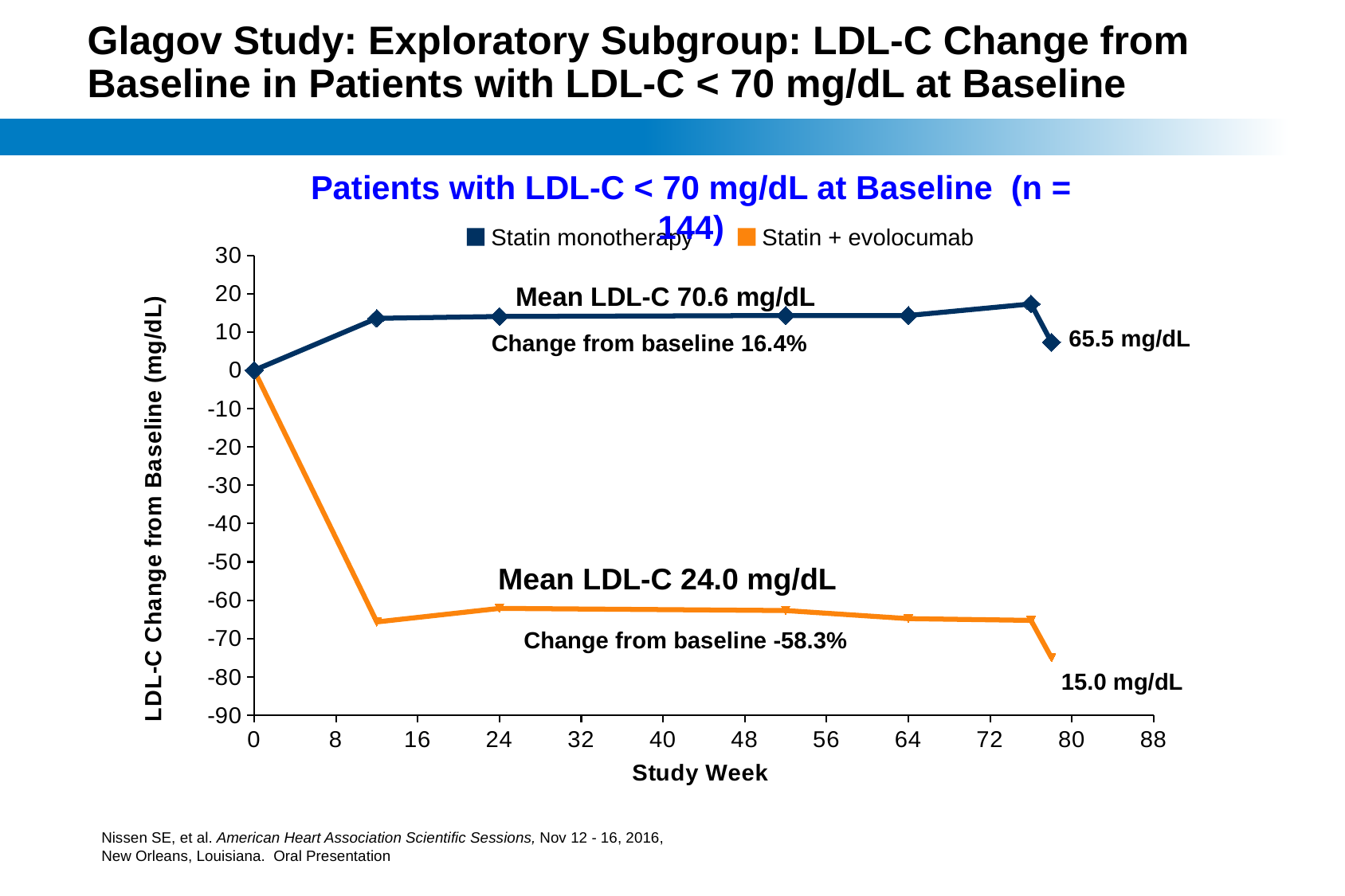
What LDL-C value is annotated at the end of the Statin + evolocumab line? 15.0 mg/dL What mean LDL-C value is annotated for the Statin monotherapy line? 70.6 mg/dL What mean LDL-C value is annotated for the Statin + evolocumab line? 24.0 mg/dL Is the value for Statin + evolocumab at week 12 greater or less than -60? less How many series does the legend list? 2 What kind of chart is shown on the slide? line chart Is the value for Statin monotherapy at week 24 greater or less than 10? greater What percentage change from baseline is annotated for the Statin monotherapy line? 16.4% What are the two series named in the legend? Statin monotherapy and Statin + evolocumab What is the label of the y axis? LDL-C Change from Baseline (mg/dL) What percentage change from baseline is annotated for the Statin + evolocumab line? -58.3% At week 52, which series has the higher LDL-C change from baseline, Statin monotherapy or Statin + evolocumab? Statin monotherapy